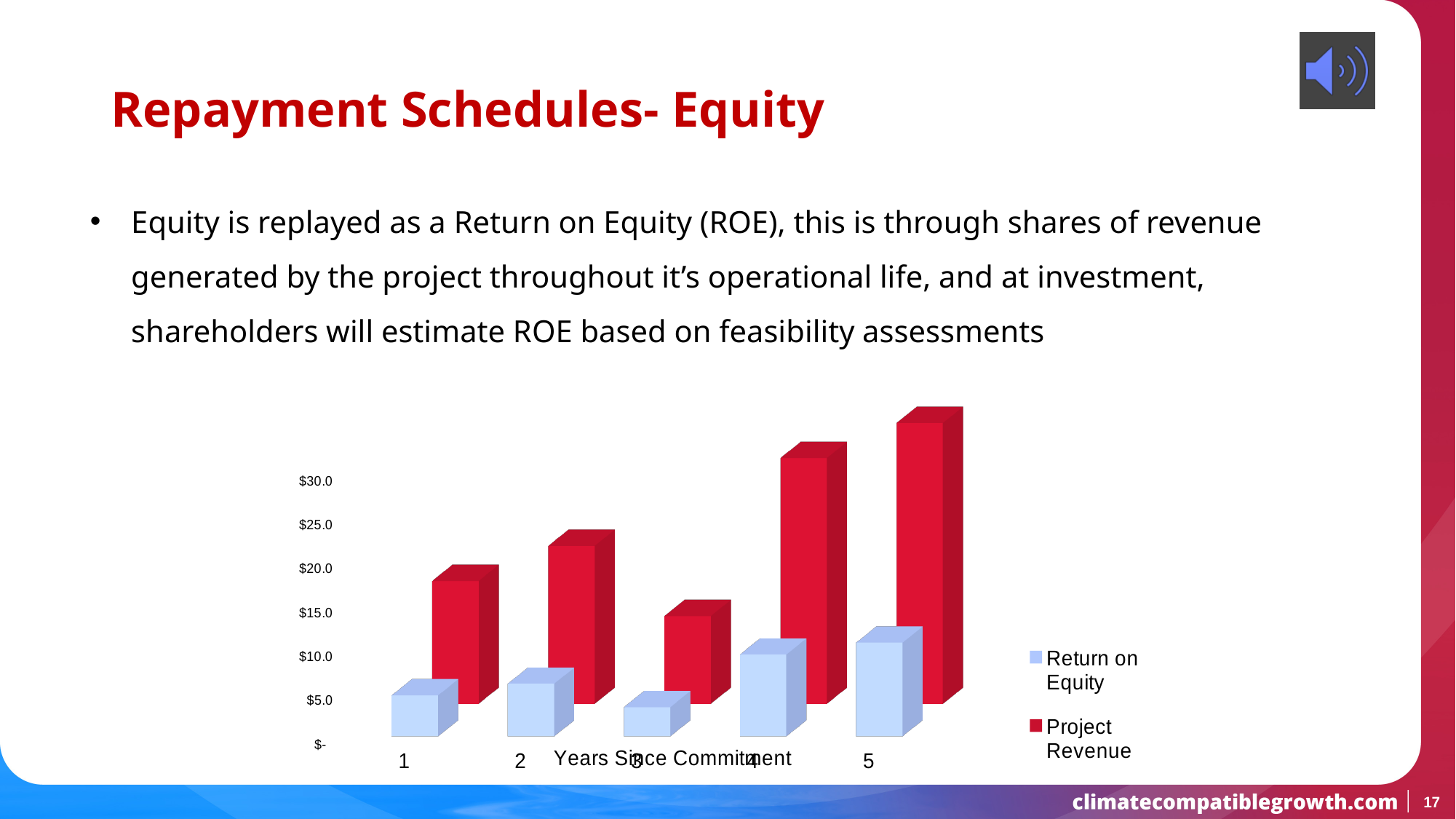
In which year is Return on Equity lowest? 3 In which year is Project Revenue lowest? 3 What is the title of the x axis of the chart? Years Since Commitment In which year is Project Revenue highest? 5 How many years (categories) are shown on the x axis of the chart? 5 What kind of chart is shown on the slide? bar chart Is the Project Revenue value for year 3 greater or less than $20.0? less Is the Return on Equity value for year 4 greater or less than $5.0? greater Is the Return on Equity value for year 3 greater or less than $10.0? less How many series does the chart legend list? 2 Which year has the larger Project Revenue, year 1 or year 2? 2